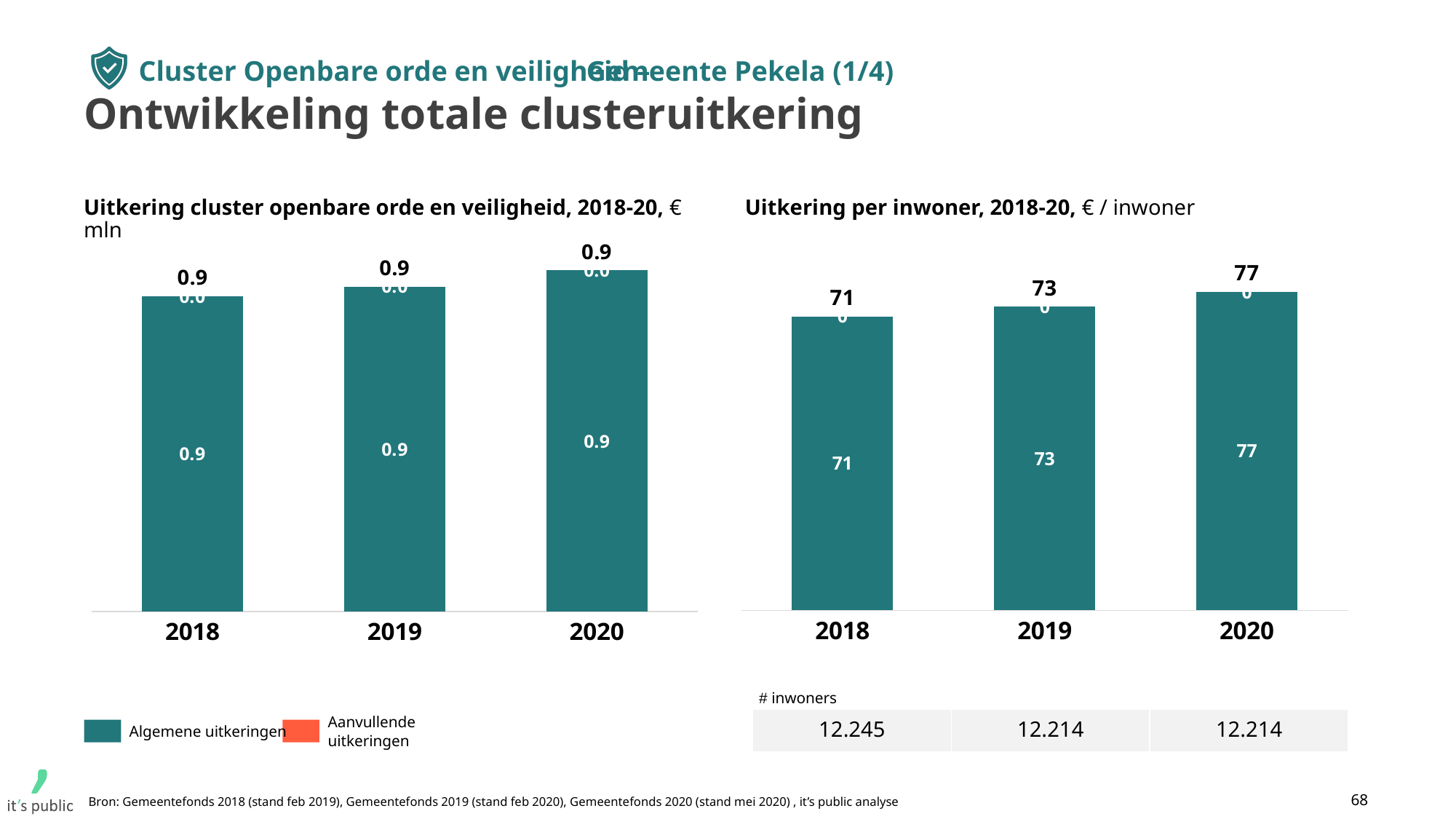
In the chart 'Uitkering per inwoner, 2018-20', what is the difference between the 2020 and 2018 values? 6 What kind of chart is the chart 'Uitkering per inwoner, 2018-20'? bar chart In the chart 'Uitkering per inwoner, 2018-20', is the value for 2019 larger or smaller than the value for 2020? smaller In the chart 'Uitkering per inwoner, 2018-20', which year has the highest value? 2020 How many series does the legend of the left chart 'Uitkering cluster openbare orde en veiligheid, 2018-20' list? 2 In the chart 'Uitkering per inwoner, 2018-20', what is the value for 2020? 77 In the chart 'Uitkering per inwoner, 2018-20', do the values rise or fall from 2018 to 2020? rise In the chart 'Uitkering per inwoner, 2018-20', what is the value for 2018? 71 In the left chart 'Uitkering cluster openbare orde en veiligheid, 2018-20', what is the total value of the bar for 2019? 0.9 In the chart 'Uitkering per inwoner, 2018-20', which year has the lowest value? 2018 How many years are shown on the x axis of the left chart 'Uitkering cluster openbare orde en veiligheid, 2018-20'? 3 In the left chart 'Uitkering cluster openbare orde en veiligheid, 2018-20', what is the value of 'Algemene uitkeringen' for 2020? 0.9